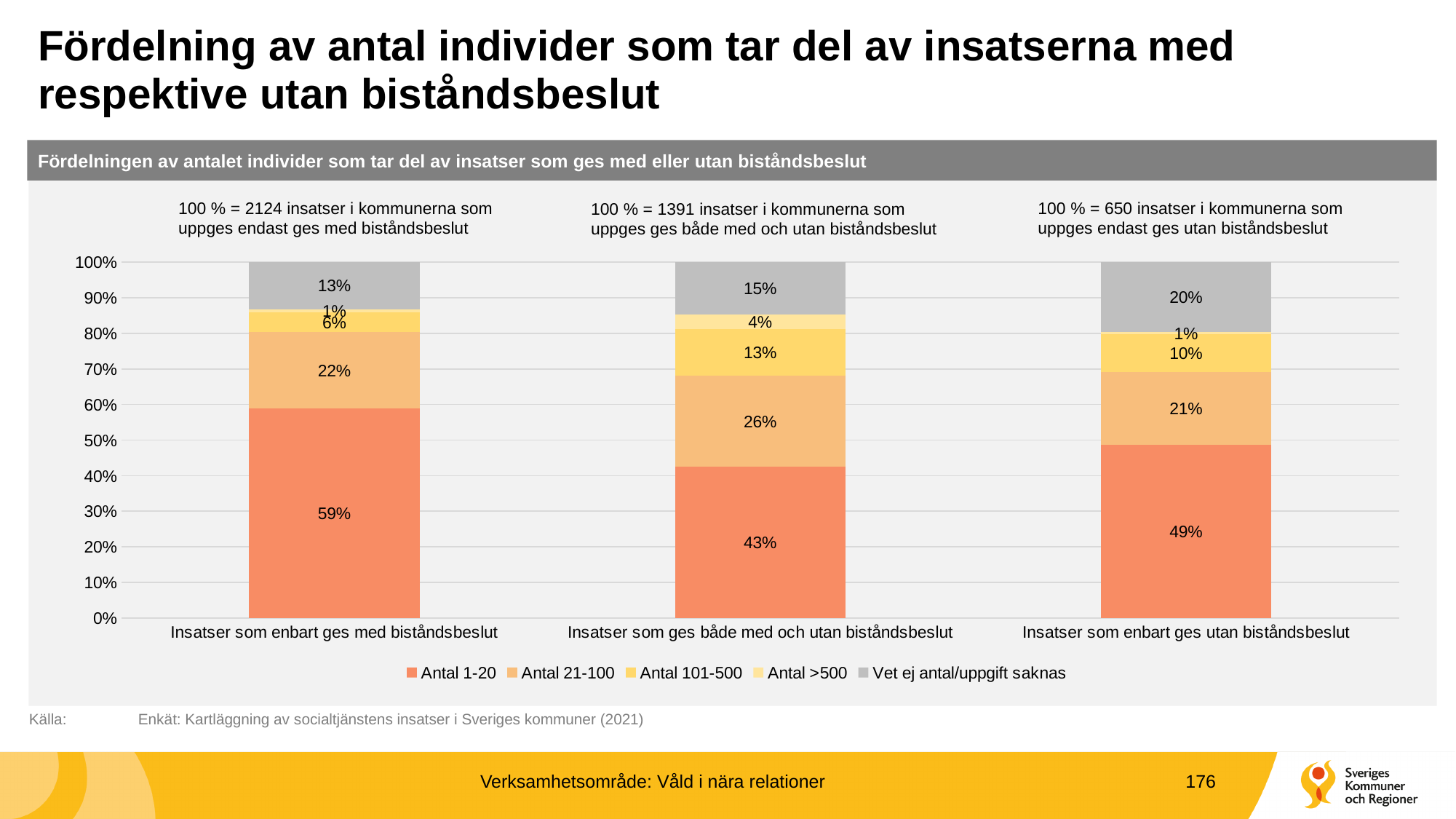
What kind of chart is shown on the slide? stacked bar chart What is the value for 'Antal 1-20' in the category 'Insatser som enbart ges med biståndsbeslut'? 59% According to the note above the chart, how many insatser does 100 % correspond to for 'Insatser som ges både med och utan biståndsbeslut'? 1391 Which category has the lowest value for 'Vet ej antal/uppgift saknas'? Insatser som enbart ges med biståndsbeslut Which is larger: the 'Antal 101-500' value for 'Insatser som ges både med och utan biståndsbeslut' or for 'Insatser som enbart ges med biståndsbeslut'? Insatser som ges både med och utan biståndsbeslut Which category has the highest value for 'Antal 1-20'? Insatser som enbart ges med biståndsbeslut How many categories are shown on the x axis? 3 How many series does the legend list? 5 What is the value for 'Antal 101-500' in the category 'Insatser som enbart ges utan biståndsbeslut'? 10% What is the value for 'Antal 21-100' in the category 'Insatser som ges både med och utan biståndsbeslut'? 26% What is the difference between the 'Antal 1-20' values for 'Insatser som enbart ges med biståndsbeslut' and 'Insatser som ges både med och utan biståndsbeslut'? 16% What is the value for 'Vet ej antal/uppgift saknas' in the category 'Insatser som enbart ges utan biståndsbeslut'? 20%